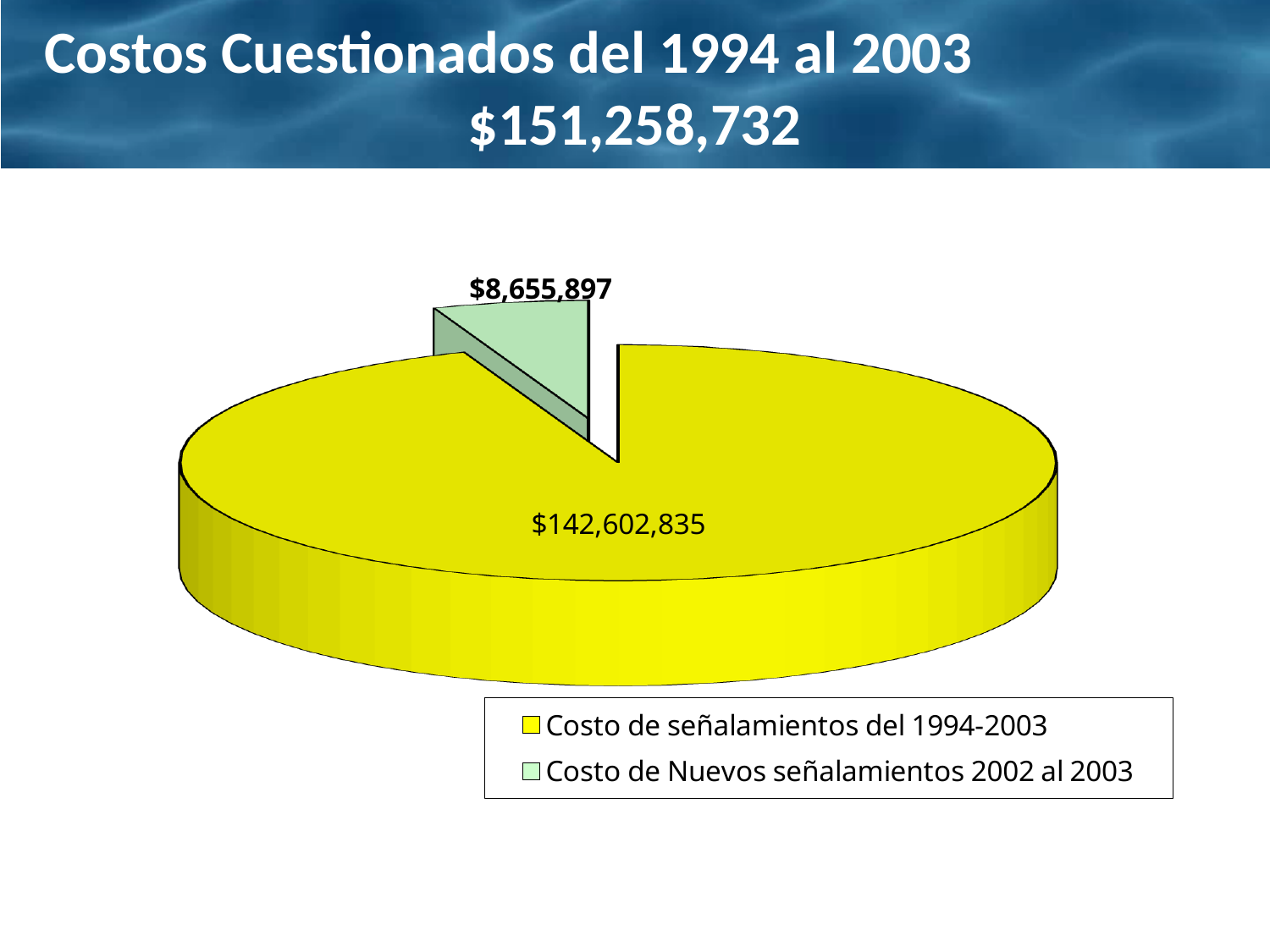
Which is larger: the value for Costo de señalamientos del 1994-2003 or the value for Costo de Nuevos señalamientos 2002 al 2003? Costo de señalamientos del 1994-2003 How many entries does the legend list? 2 What is the value for Costo de señalamientos del 1994-2003? $142,602,835 Which category has the largest slice of the pie? Costo de señalamientos del 1994-2003 Which category has the smallest slice of the pie? Costo de Nuevos señalamientos 2002 al 2003 What colour is the slice for Costo de Nuevos señalamientos 2002 al 2003? Light green What is the value for Costo de Nuevos señalamientos 2002 al 2003? $8,655,897 How many slices does the pie chart have? 2 What share of the pie does Costo de Nuevos señalamientos 2002 al 2003 represent, to one decimal place? 5.7% What is the difference between the value for Costo de señalamientos del 1994-2003 and the value for Costo de Nuevos señalamientos 2002 al 2003? $133,946,938 What is the total of the two slices in the pie chart? $151,258,732 What type of chart is shown on the slide? Pie chart